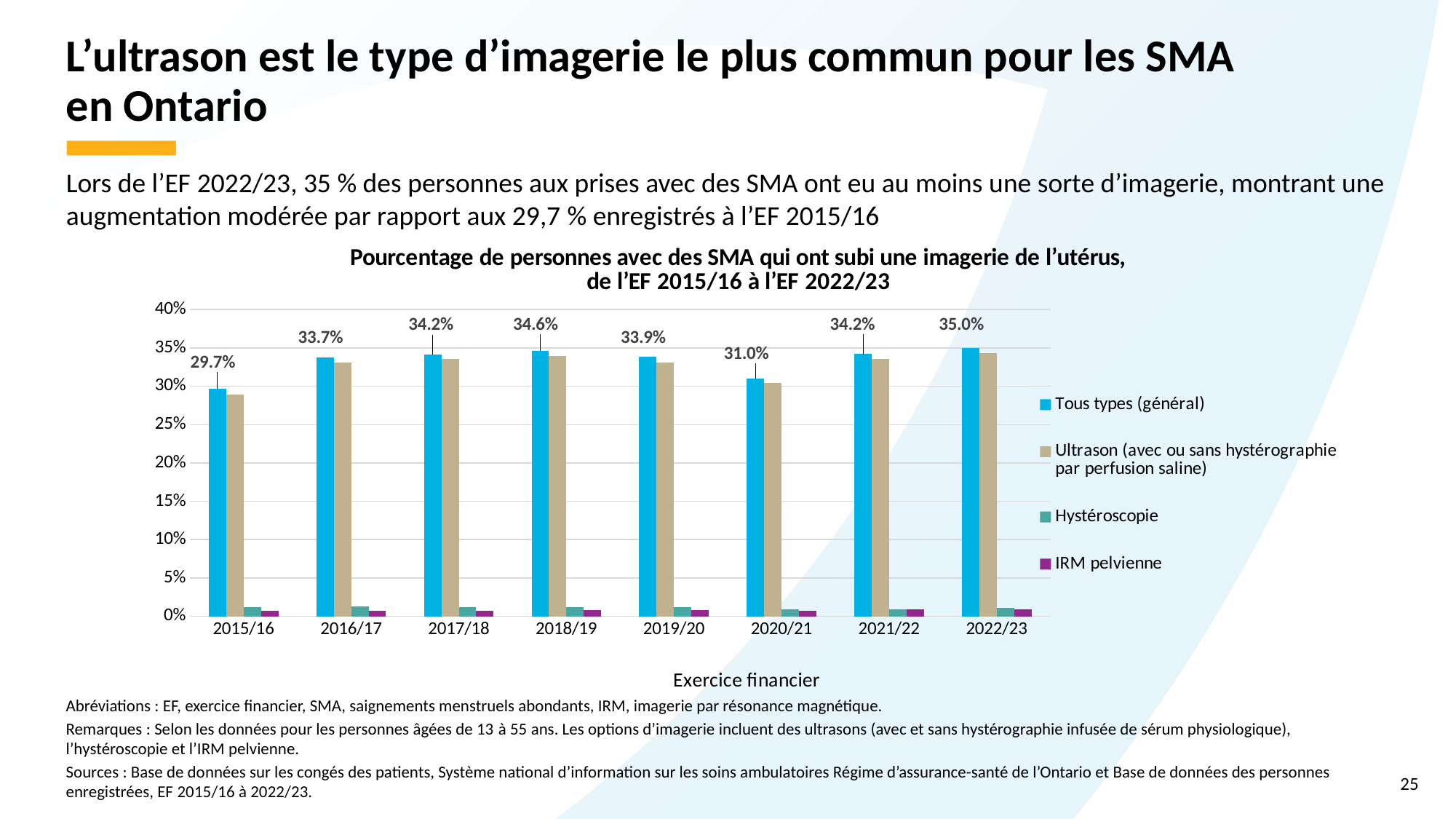
In which fiscal year is the Tous types (général) value lowest? 2015/16 In which fiscal year is the Tous types (général) value highest? 2022/23 Which is larger for Tous types (général): 2016/17 or 2019/20? 2019/20 What is the difference between the Tous types (général) values for 2022/23 and 2015/16? 5.3 percentage points What is the value for Tous types (général) in 2022/23? 35.0% What is the value for Tous types (général) in 2020/21? 31.0% How many series does the legend list? 4 Is the value for Ultrason (avec ou sans hystérographie par perfusion saline) in 2015/16 greater or less than 30%? less How many fiscal years are shown on the x axis? 8 What kind of chart is shown on the slide? Bar chart What is the title of the x axis? Exercice financier What is the value for Tous types (général) in 2015/16? 29.7%